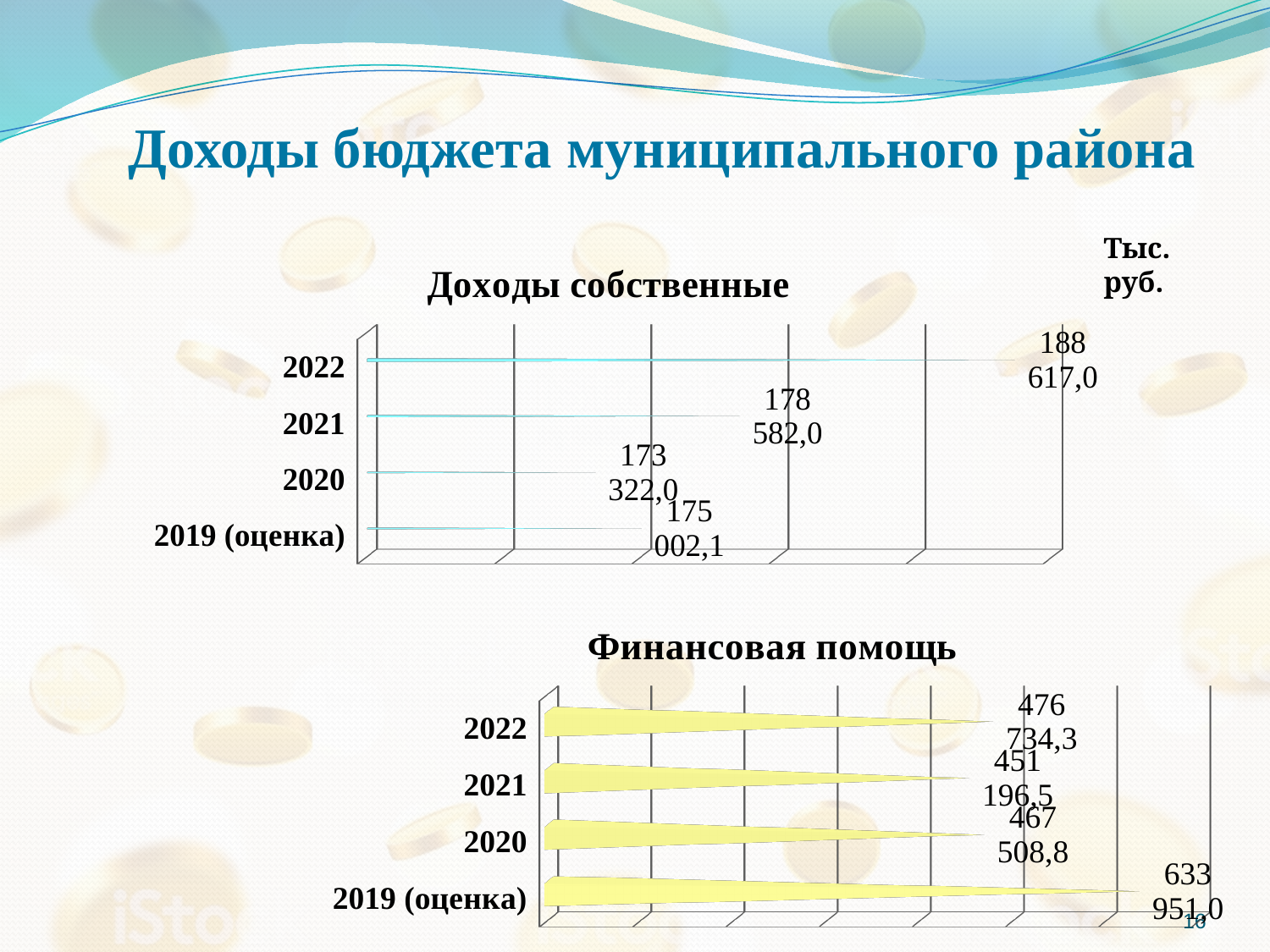
In the 'Финансовая помощь' chart, what is the value for 2019 (оценка)? 633 951,0 In the 'Доходы собственные' chart, which year has the highest value? 2022 In the 'Финансовая помощь' chart, which year has the highest value? 2019 (оценка) In the 'Доходы собственные' chart, what is the value for 2022? 188 617,0 In the 'Финансовая помощь' chart, what is the value for 2021? 451 196,5 In the 'Финансовая помощь' chart, which year has the lowest value? 2021 In the 'Финансовая помощь' chart, which is larger: the value for 2022 or the value for 2020? 2022 What type of chart is the 'Доходы собственные' chart? Bar chart How many categories (years) are shown in the 'Финансовая помощь' chart? 4 In the 'Доходы собственные' chart, what is the value for 2019 (оценка)? 175 002,1 In the 'Доходы собственные' chart, what is the difference between the values for 2022 and 2021? 10 035,0 In the 'Доходы собственные' chart, which year has the lowest value? 2020